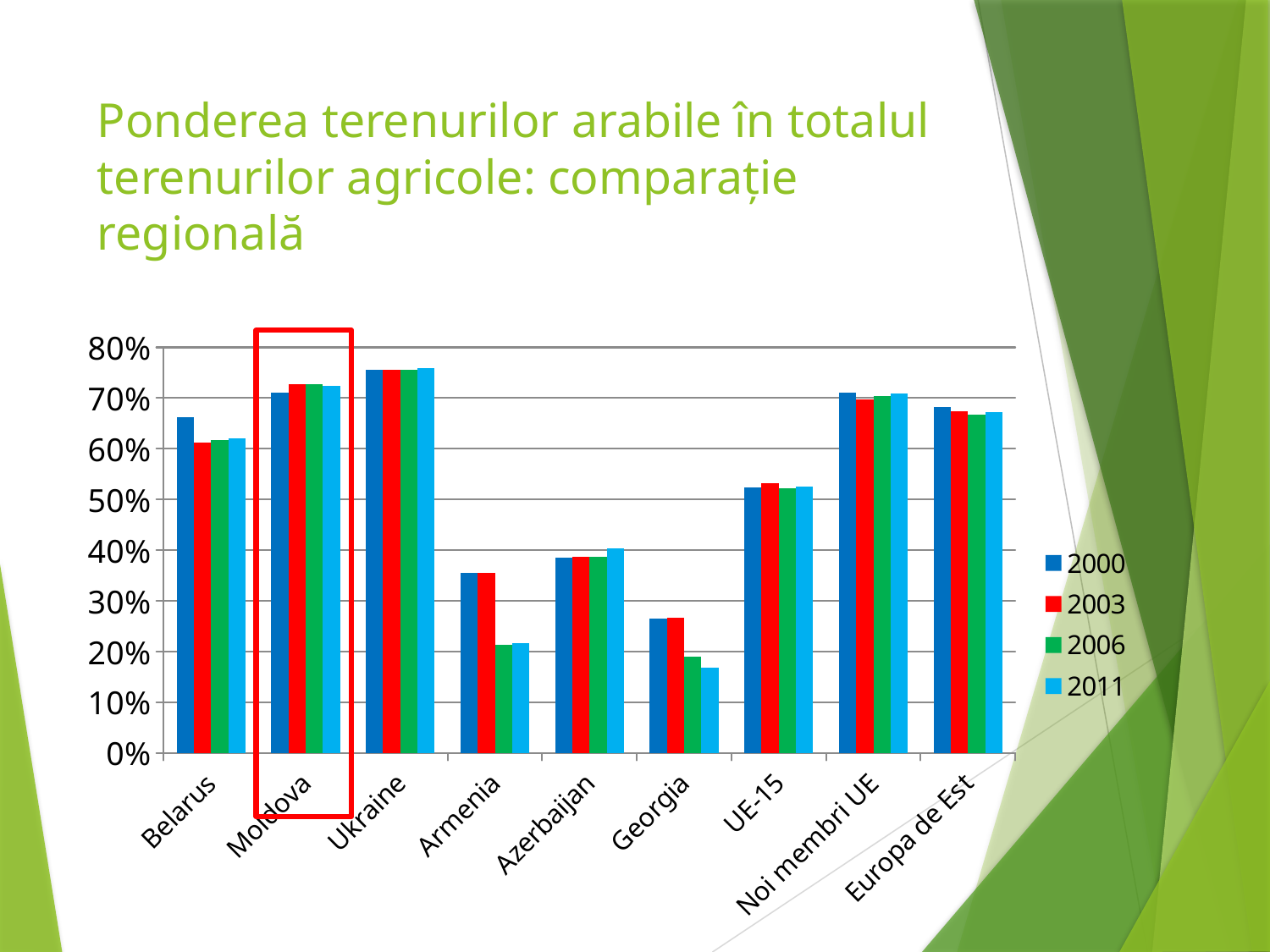
Which country or region has the highest share of arable land in the chart? Ukraine Is the value for Belarus in 2000 greater or less than 60%? greater What kind of chart is shown on the slide? bar chart Which country is highlighted with a red box on the chart? Moldova Is the value for Georgia in 2011 greater or less than 20%? less Is the value for Moldova in 2003 greater or less than 70%? greater How many countries or regions are shown on the x axis of the chart? 9 Which country or region has the lowest share of arable land in 2011? Georgia Which is larger in 2000: the value for Armenia or the value for Azerbaijan? Azerbaijan Does the value for Georgia rise or fall from 2000 to 2011? fall How many series does the chart's legend list? 4